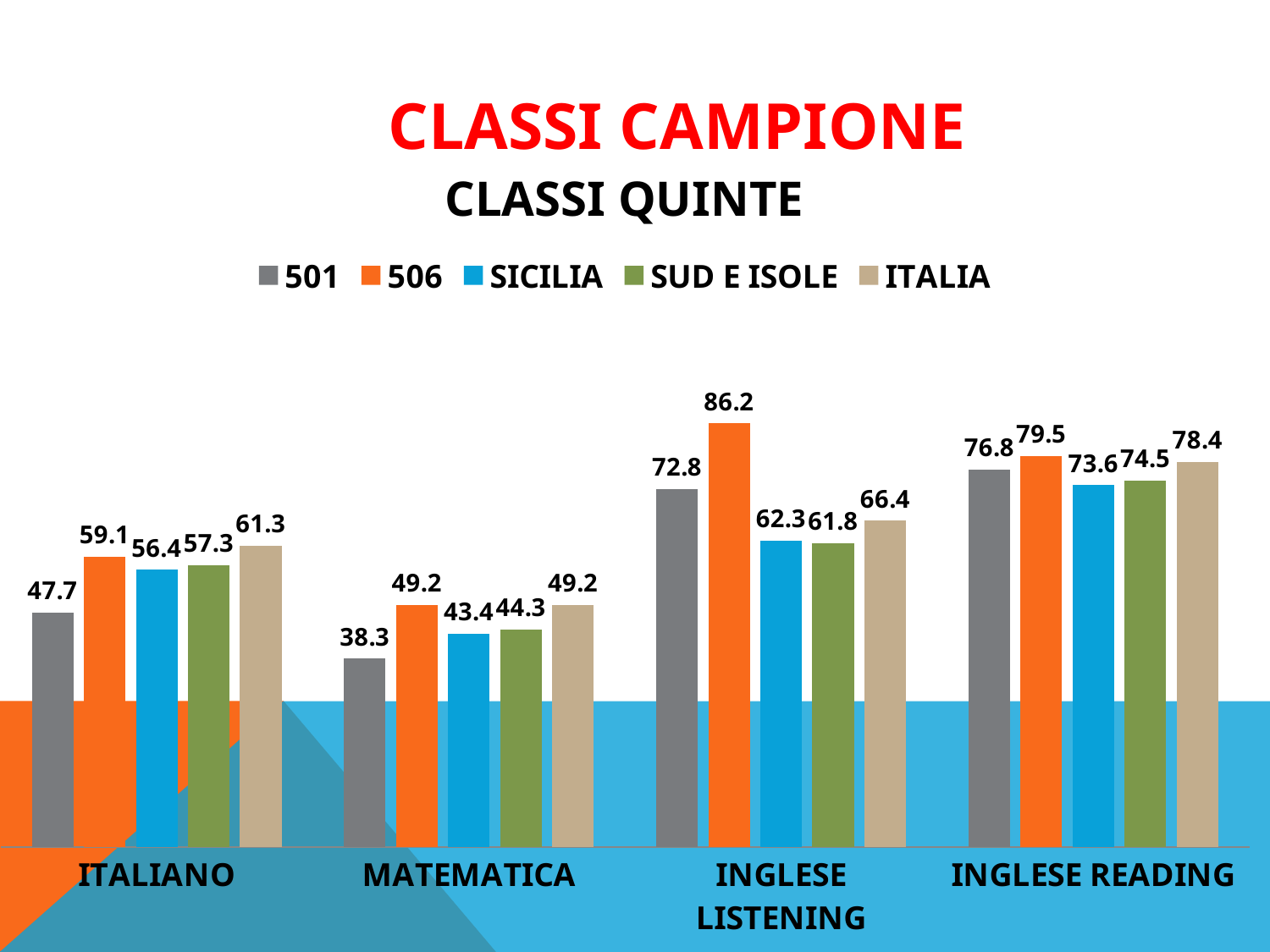
What is the value for 501 in MATEMATICA? 38.3 What is the value for 506 in INGLESE LISTENING? 86.2 What kind of chart is shown on the slide? bar chart How many series does the legend list? 5 How many categories are shown on the x axis? 4 Which is larger in MATEMATICA: the value for SICILIA or the value for SUD E ISOLE? SUD E ISOLE What is the difference between the 506 and 501 values in INGLESE LISTENING? 13.4 What is the value for ITALIA in ITALIANO? 61.3 What is the value for SICILIA in INGLESE READING? 73.6 Which series has the lowest value in ITALIANO? 501 Which series has the highest value in INGLESE LISTENING? 506